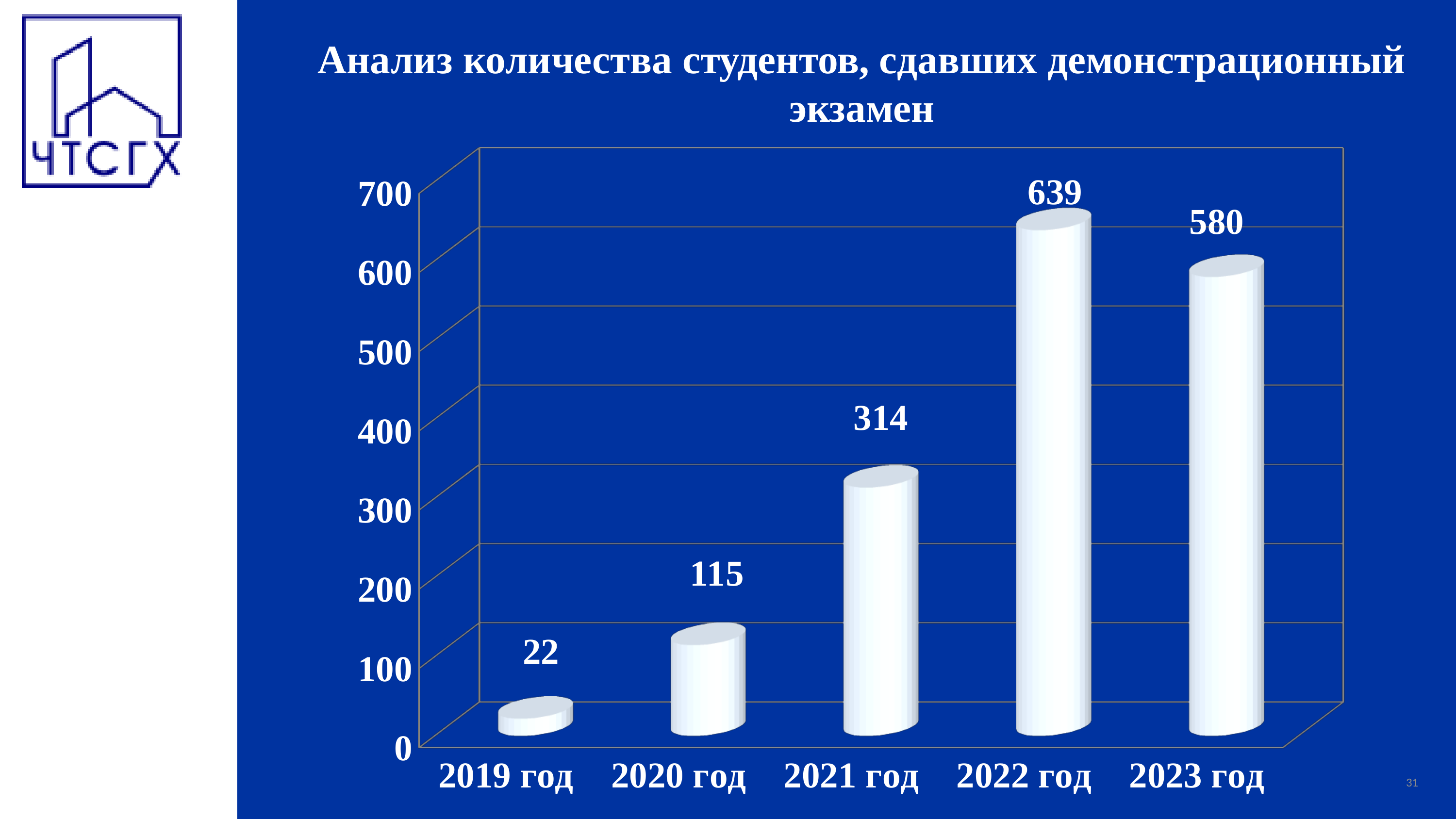
What is the value for 2019 год? 22 What is the value for 2021 год? 314 What is the title of the chart? Анализ количества студентов, сдавших демонстрационный экзамен Is the value for 2023 год greater or less than 500? greater Which is larger, the value for 2023 год or the value for 2021 год? 2023 год What kind of chart is shown on the slide? bar chart What is the difference between the values for 2021 год and 2020 год? 199 Which year has the lowest value? 2019 год Which year has the highest value? 2022 год What is the difference between the values for 2022 год and 2023 год? 59 How many years are shown on the chart? 5 What is the value for 2022 год? 639